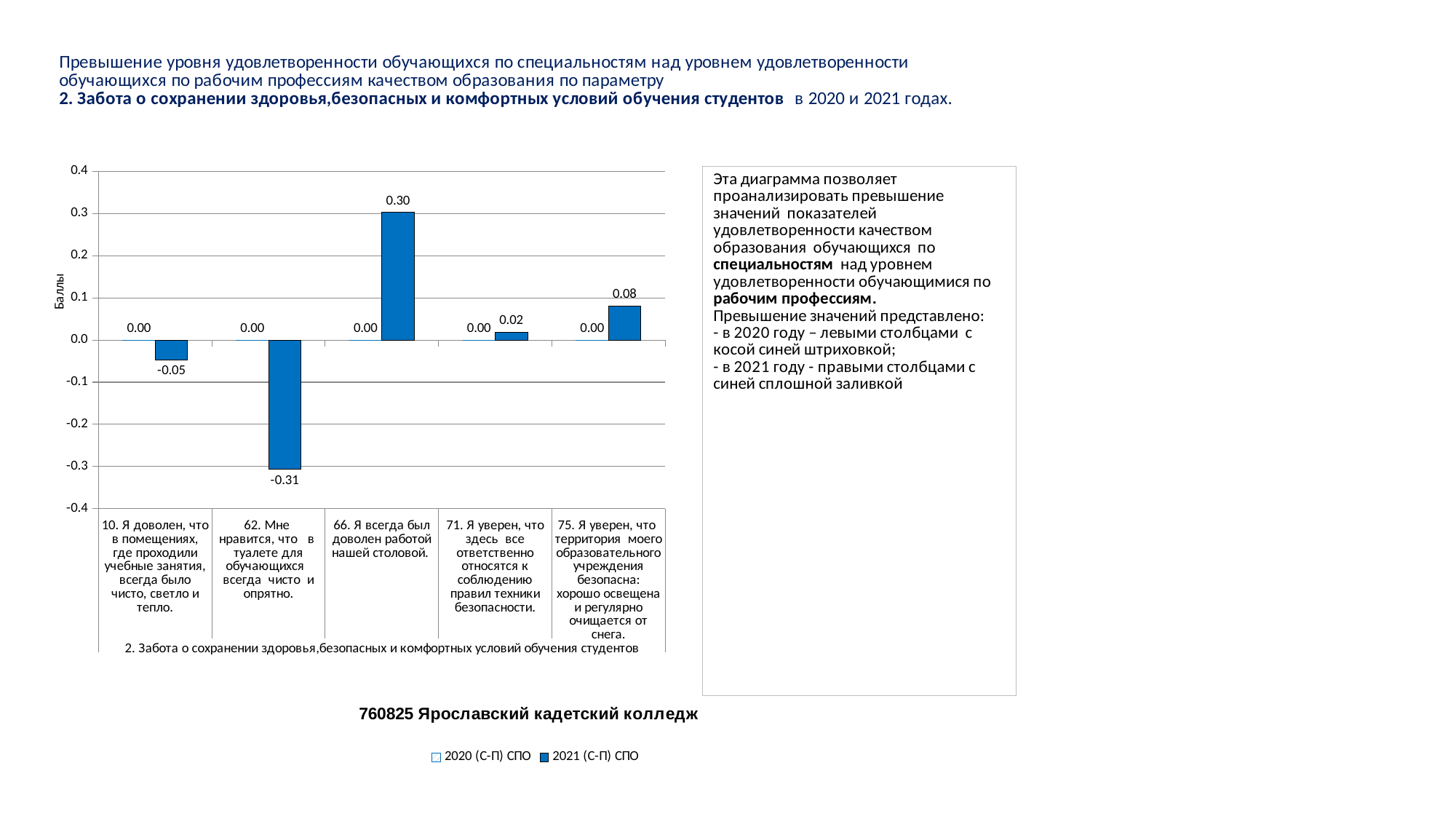
Which is larger: the 2021 (С-П) СПО value for category 71 or for category 75? Category 75 What is the difference between the 2021 (С-П) СПО values for category 75 and category 71? 0.06 Which category has the lowest 2021 (С-П) СПО value? 62. Мне нравится, что в туалете для обучающихся всегда чисто и опрятно. How many categories are shown on the x axis of the chart? 5 How many series does the chart legend list? 2 What is the 2021 (С-П) СПО value for category 62 (Мне нравится, что в туалете для обучающихся всегда чисто и опрятно)? -0.31 What type of chart is shown on the slide? Bar chart What is the label of the vertical axis of the chart? Баллы What is the 2020 (С-П) СПО value for category 75 (Я уверен, что территория моего образовательного учреждения безопасна)? 0.00 What is the 2021 (С-П) СПО value for category 66 (Я всегда был доволен работой нашей столовой)? 0.30 Which category has the highest 2021 (С-П) СПО value? 66. Я всегда был доволен работой нашей столовой. What is the 2021 (С-П) СПО value for category 10 (Я доволен, что в помещениях, где проходили учебные занятия, всегда было чисто, светло и тепло)? -0.05